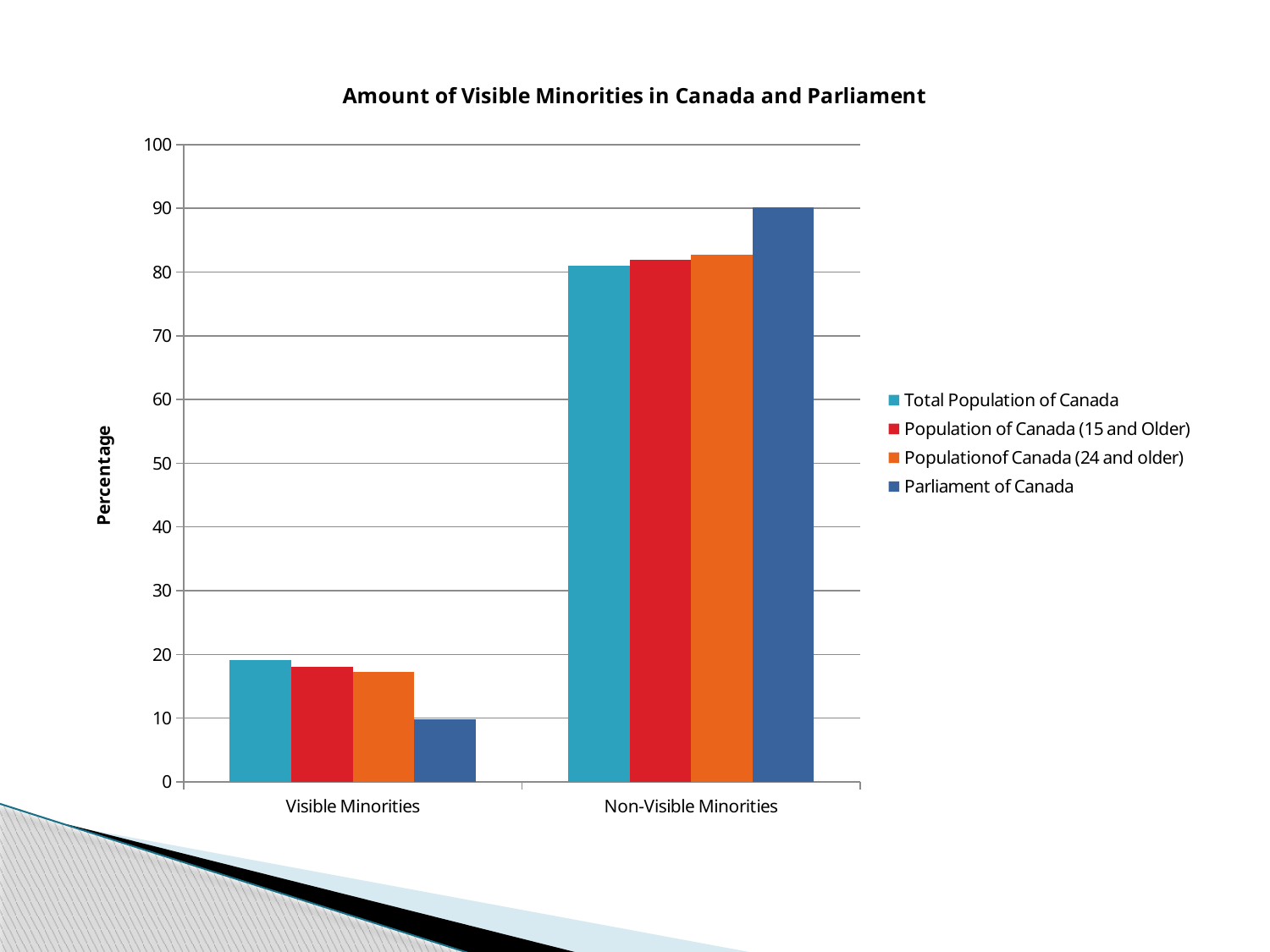
Is the value for Total Population of Canada in the Non-Visible Minorities category greater or less than 80? greater Which series has the lowest value for Visible Minorities? Parliament of Canada How many categories are shown on the x axis? 2 What is the title of the chart? Amount of Visible Minorities in Canada and Parliament Which series has the highest value for Visible Minorities? Total Population of Canada What is the label on the vertical axis? Percentage For Parliament of Canada, which category has the larger value: Visible Minorities or Non-Visible Minorities? Non-Visible Minorities How many series does the legend list? 4 What kind of chart is shown on the slide? bar chart Which series has the highest value for Non-Visible Minorities? Parliament of Canada Is the value for Total Population of Canada in the Visible Minorities category greater or less than 20? less